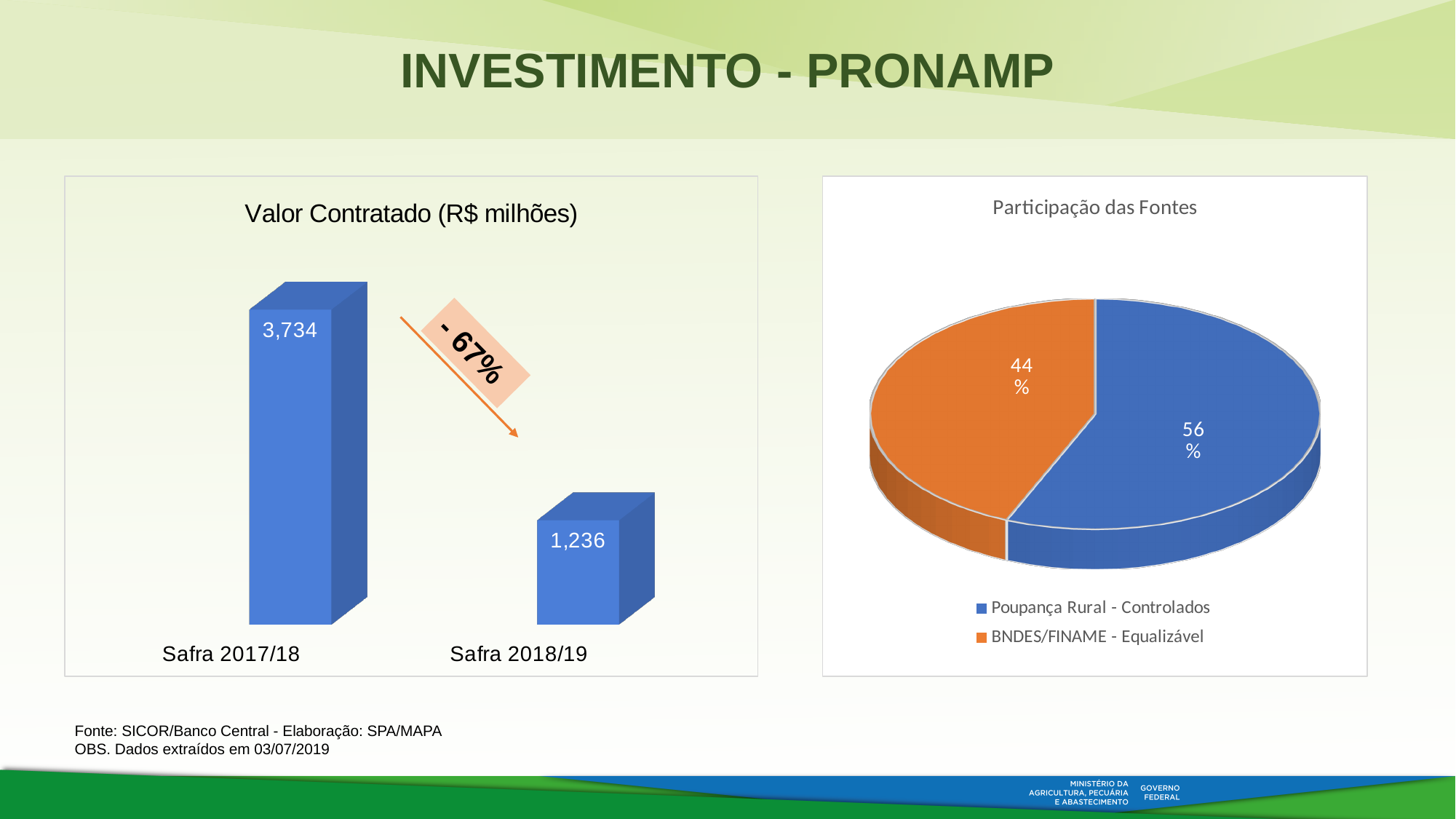
What kind of chart is the 'Valor Contratado (R$ milhões)' chart? bar chart In the 'Valor Contratado (R$ milhões)' chart, which safra has the lowest value? Safra 2018/19 In the 'Valor Contratado (R$ milhões)' chart, what percentage change is annotated between the two safras? - 67% What kind of chart is the 'Participação das Fontes' chart? pie chart In the 'Participação das Fontes' chart, what share does BNDES/FINAME - Equalizável have? 44% In the 'Valor Contratado (R$ milhões)' chart, what is the value for Safra 2017/18? 3,734 In the 'Valor Contratado (R$ milhões)' chart, what is the difference between the Safra 2017/18 and Safra 2018/19 values? 2,498 In the 'Valor Contratado (R$ milhões)' chart, do the values rise or fall from Safra 2017/18 to Safra 2018/19? fall In the 'Valor Contratado (R$ milhões)' chart, what is the value for Safra 2018/19? 1,236 How many categories are shown in the 'Valor Contratado (R$ milhões)' chart? 2 In the 'Valor Contratado (R$ milhões)' chart, which safra has the higher value? Safra 2017/18 In the 'Participação das Fontes' chart, what share does Poupança Rural - Controlados have? 56%